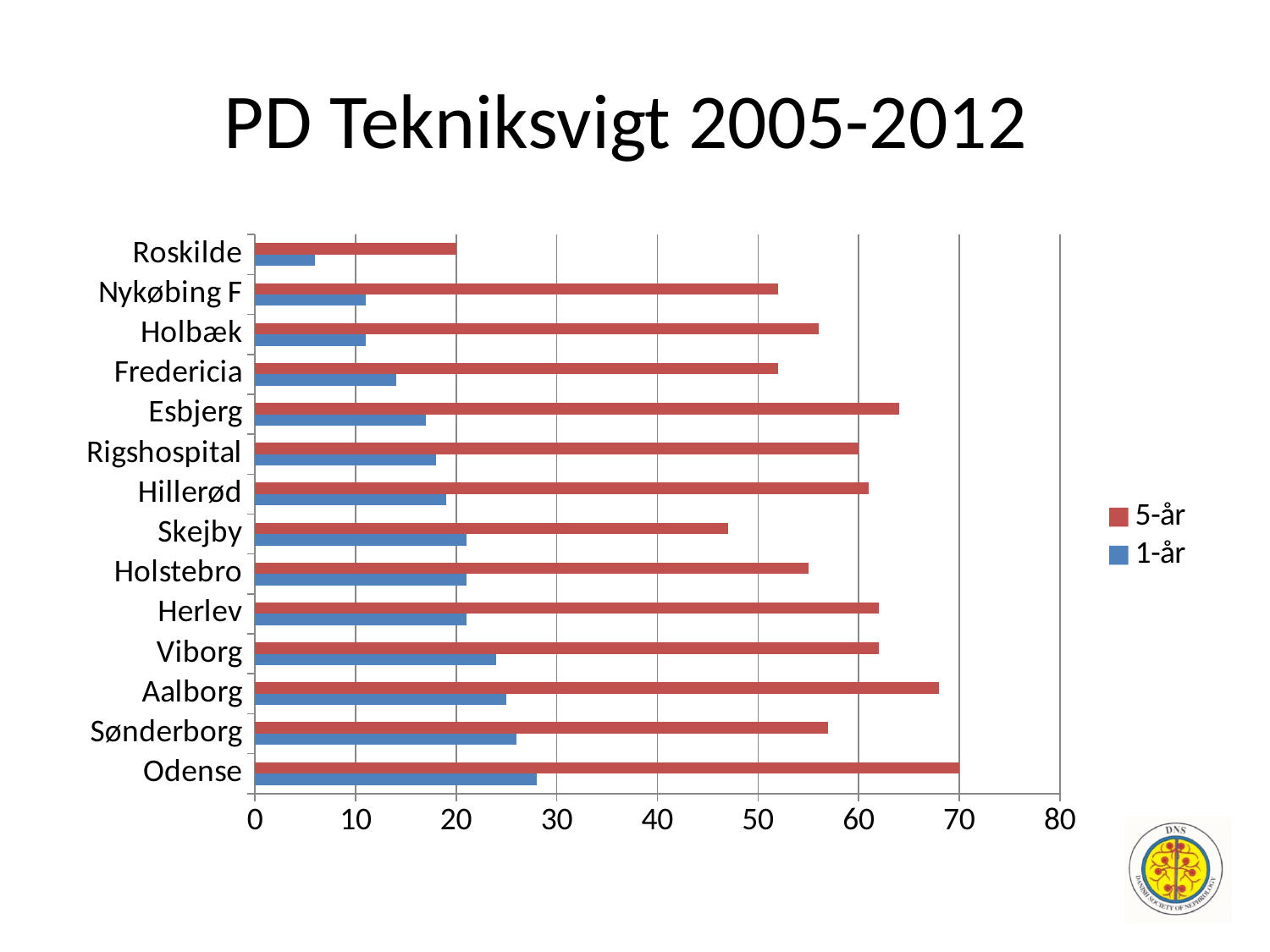
Is the 1-år value for Odense greater or less than 20? greater What are the two series named in the legend? 5-år and 1-år What is the 5-år value for Rigshospital? 60 Which hospital has the lowest 1-år value? Roskilde Which hospital has the lowest 5-år value? Roskilde Which is larger, the 5-år value for Aalborg or the 5-år value for Holstebro? Aalborg Which hospital has the highest 5-år value? Odense How many hospitals (categories) are shown on the chart? 14 What kind of chart is shown on the slide? bar chart Is the 5-år value for Skejby greater or less than 50? less How many series does the legend list? 2 What is the 5-år value for Odense? 70